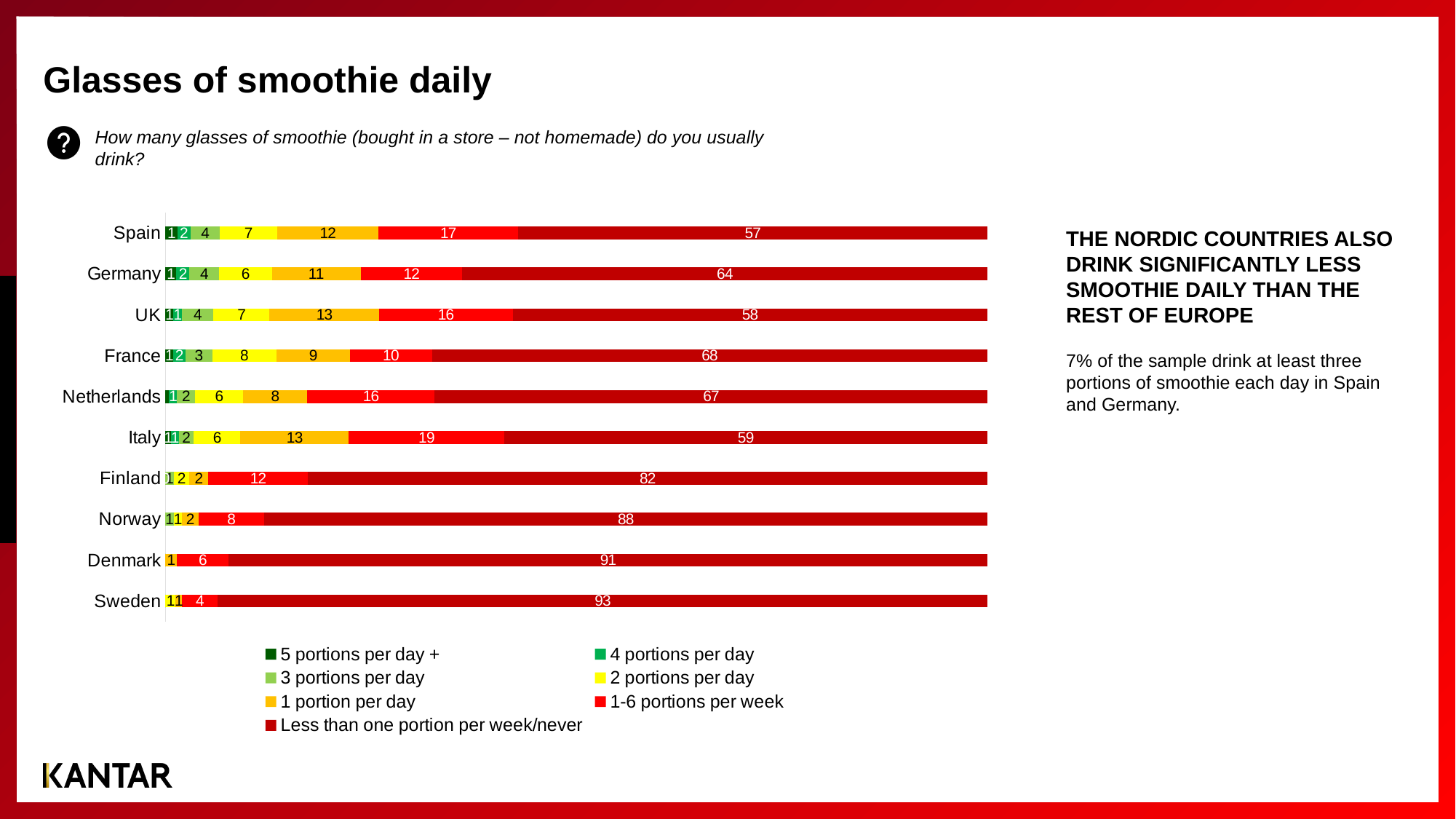
Which country has the highest value for 'Less than one portion per week/never'? Sweden How many series does the legend list? 7 Which country has the lowest value for 'Less than one portion per week/never'? Spain What is the value for the UK in the '1 portion per day' series? 13 Which is larger for '1-6 portions per week': Spain or Germany? Spain What kind of chart is shown on the slide? Stacked bar chart How many countries are shown in the chart? 10 What is the value for Italy in the '1-6 portions per week' series? 19 What is the value for France in the '2 portions per day' series? 8 What is the difference between Sweden and Spain in the 'Less than one portion per week/never' series? 36 What is the value for Sweden in the 'Less than one portion per week/never' series? 93 Which country has the highest value for '1-6 portions per week'? Italy